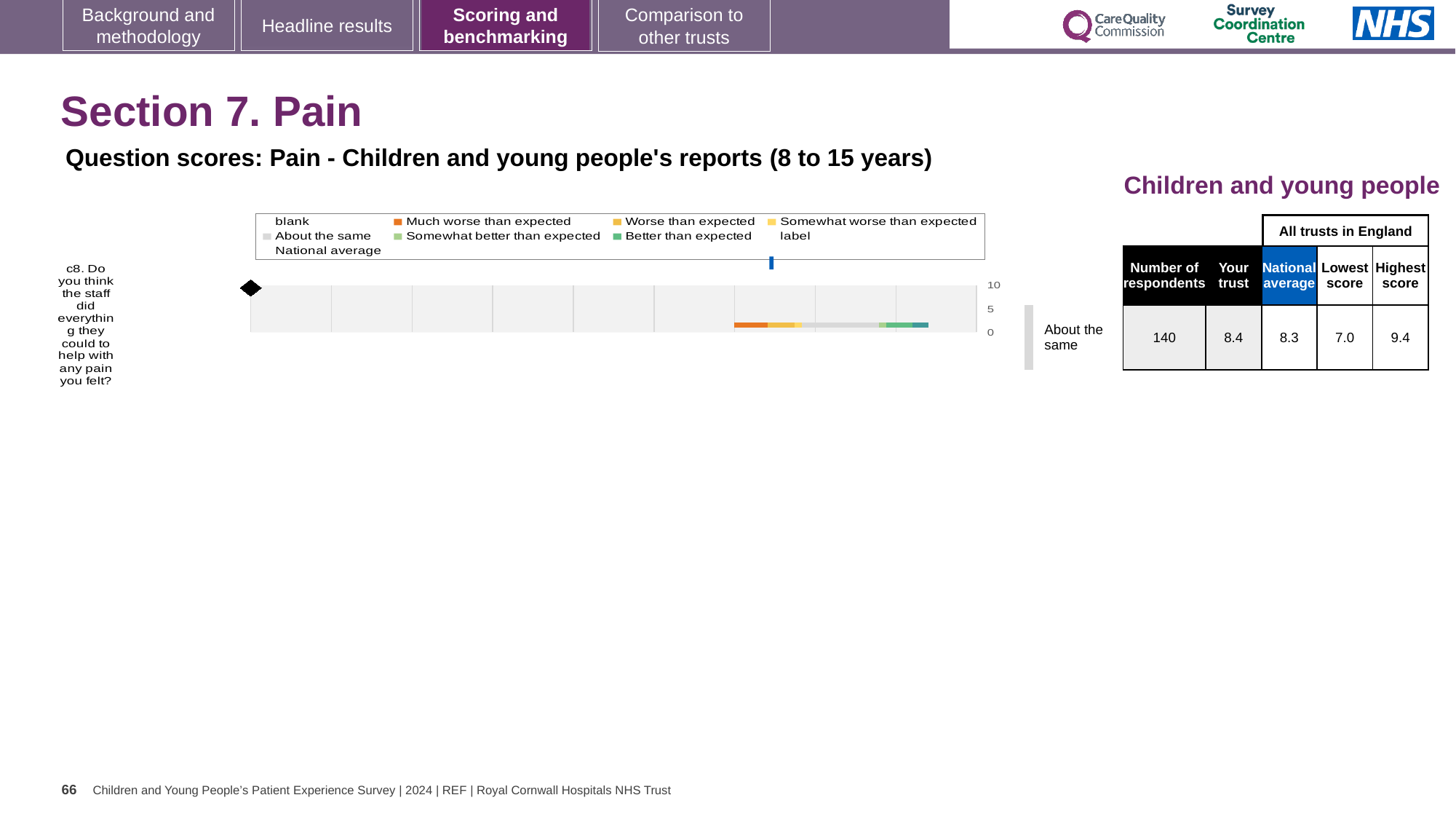
In the table beside the chart, what is the lowest score among all trusts in England for question c8? 7.0 How many survey questions (categories) are plotted in the chart? 1 For question c8, which is larger: the 'Your trust' score or the national average? Your trust What benchmark category is shown next to the chart for question c8? About the same In the table beside the chart, what is the national average score for question c8? 8.3 In the table beside the chart, what is the 'Your trust' score for question c8? 8.4 For question c8, what is the difference between the 'Your trust' score and the national average? 0.1 What kind of chart is shown for question c8 on the slide? bar chart Which legend entry is shown in orange? Much worse than expected For question c8, what is the difference between the highest score and the lowest score among all trusts in England? 2.4 In the table beside the chart, what is the highest score among all trusts in England for question c8? 9.4 In the table beside the chart, how many respondents answered question c8? 140